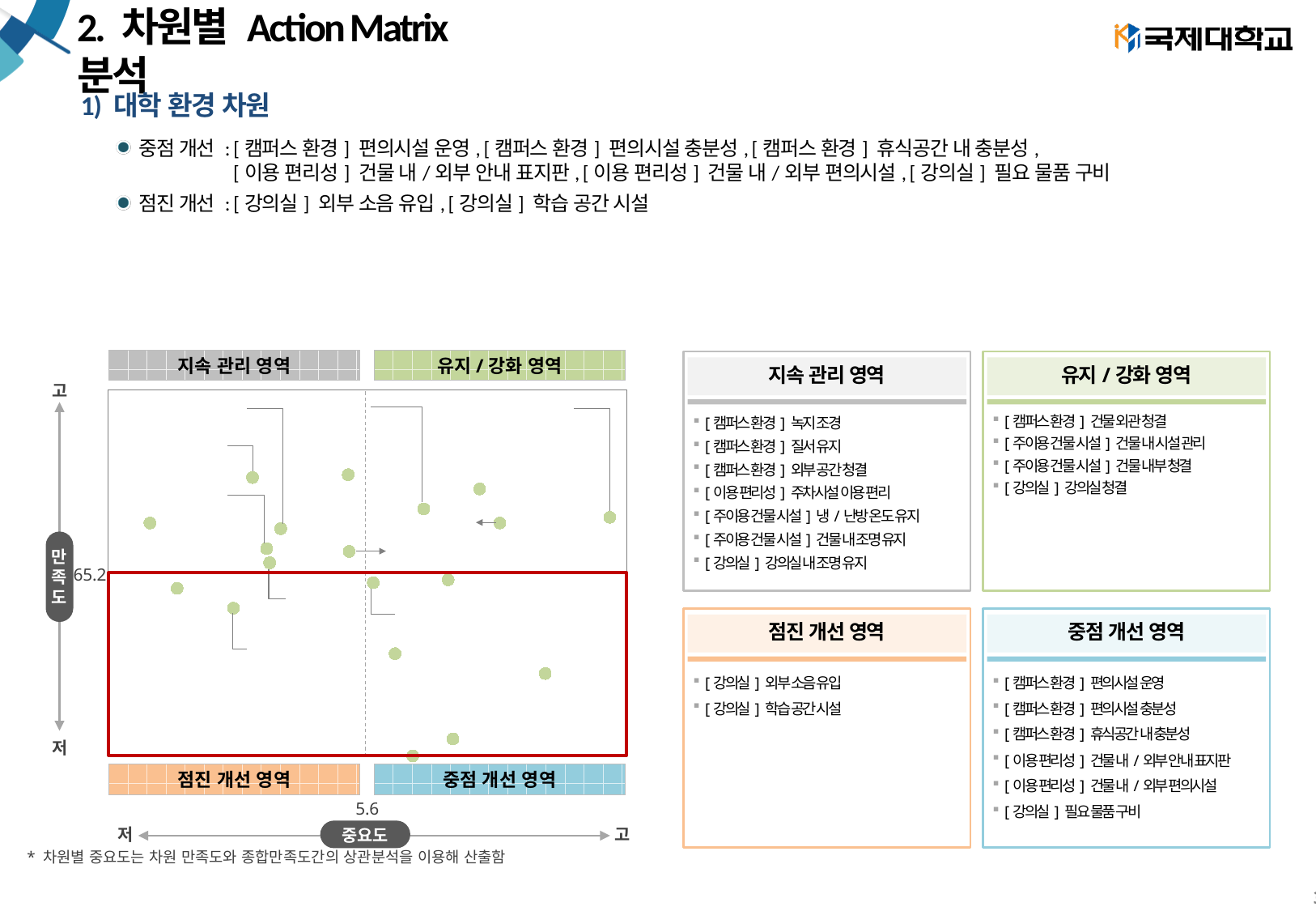
What value is marked on the vertical (만족도) axis as the dividing line between the upper and lower quadrants? 65.2 Which quadrant of the action matrix contains the fewest points? 점진 개선 영역 What is the name of the upper-right quadrant of the action matrix? 유지 / 강화 영역 How many items are listed in the 중점 개선 영역 box? 6 How many items are listed in the 점진 개선 영역 box? 2 What is the label of the vertical axis of the action matrix? 만족도 What value is marked on the horizontal (중요도) axis as the dividing line between the left and right quadrants? 5.6 What kind of chart is shown on the left of the slide? scatter chart What is the name of the lower-left quadrant of the action matrix? 점진 개선 영역 What is the name of the lower-right quadrant, outlined in red, of the action matrix? 중점 개선 영역 How many items are listed in the 유지 / 강화 영역 box? 4 What is the label of the horizontal axis of the action matrix? 중요도